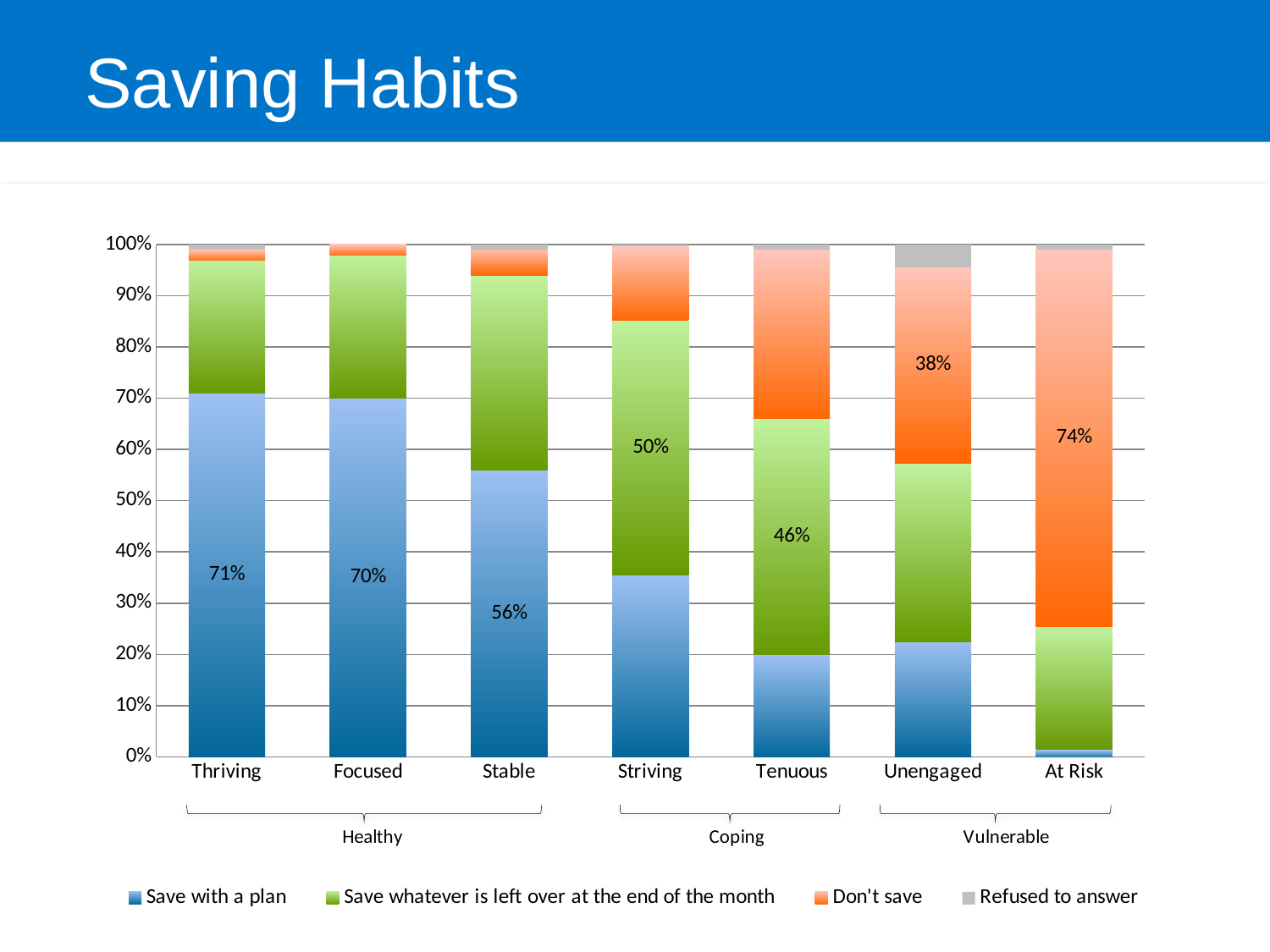
What is the labelled value for 'Save whatever is left over at the end of the month' in the Striving category? 50% What is the labelled value for 'Don't save' in the At Risk category? 74% What is the labelled value for 'Save with a plan' in the Thriving category? 71% How many series does the legend list? 4 What is the labelled value for 'Don't save' in the Unengaged category? 38% Is the 'Save with a plan' value for Tenuous greater or less than 30%? less How many categories are shown along the x axis? 7 What kind of chart is shown on the slide? Stacked bar chart What is the difference between the labelled 'Save with a plan' values for Thriving and Focused? 1% Which is larger: the labelled 'Save whatever is left over at the end of the month' value for Striving or for Tenuous? Striving Which group label covers the Thriving, Focused and Stable categories? Healthy What is the labelled value for 'Save with a plan' in the Stable category? 56%